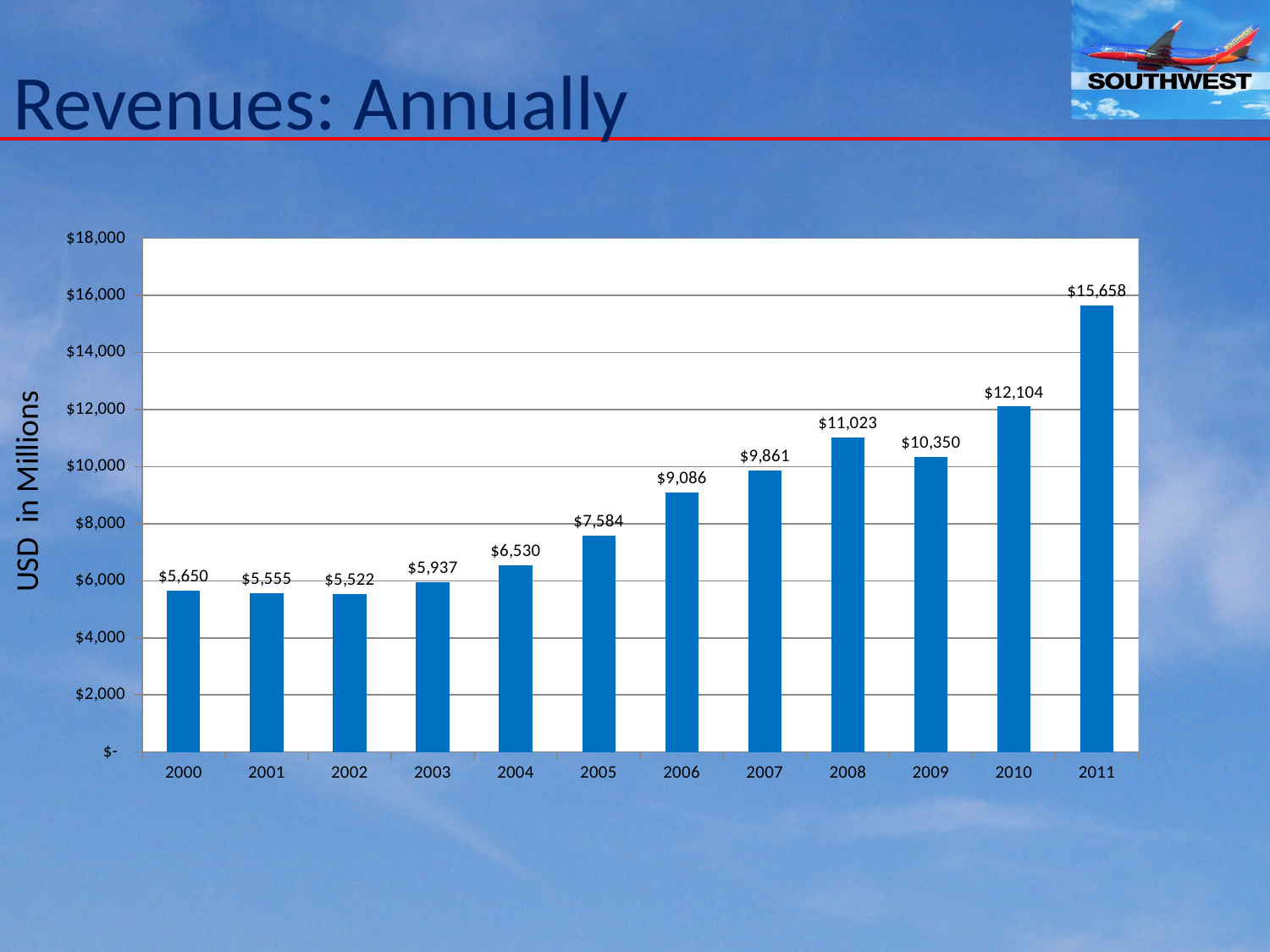
How many years are shown on the x axis? 12 What is the difference between the revenue in 2008 and the revenue in 2009? $673 Is the value for 2007 greater or less than $10,000? less Do the revenues generally rise or fall from 2002 to 2008? rise Which year has the lowest revenue? 2002 Which year has the larger revenue, 2008 or 2009? 2008 What is the revenue value shown for 2005? $7,584 Which year has the highest revenue? 2011 What is the difference between the revenue in 2011 and the revenue in 2010? $3,554 What is the revenue value shown for 2009? $10,350 What is the label on the vertical axis? USD in Millions What kind of chart is shown on the slide? bar chart